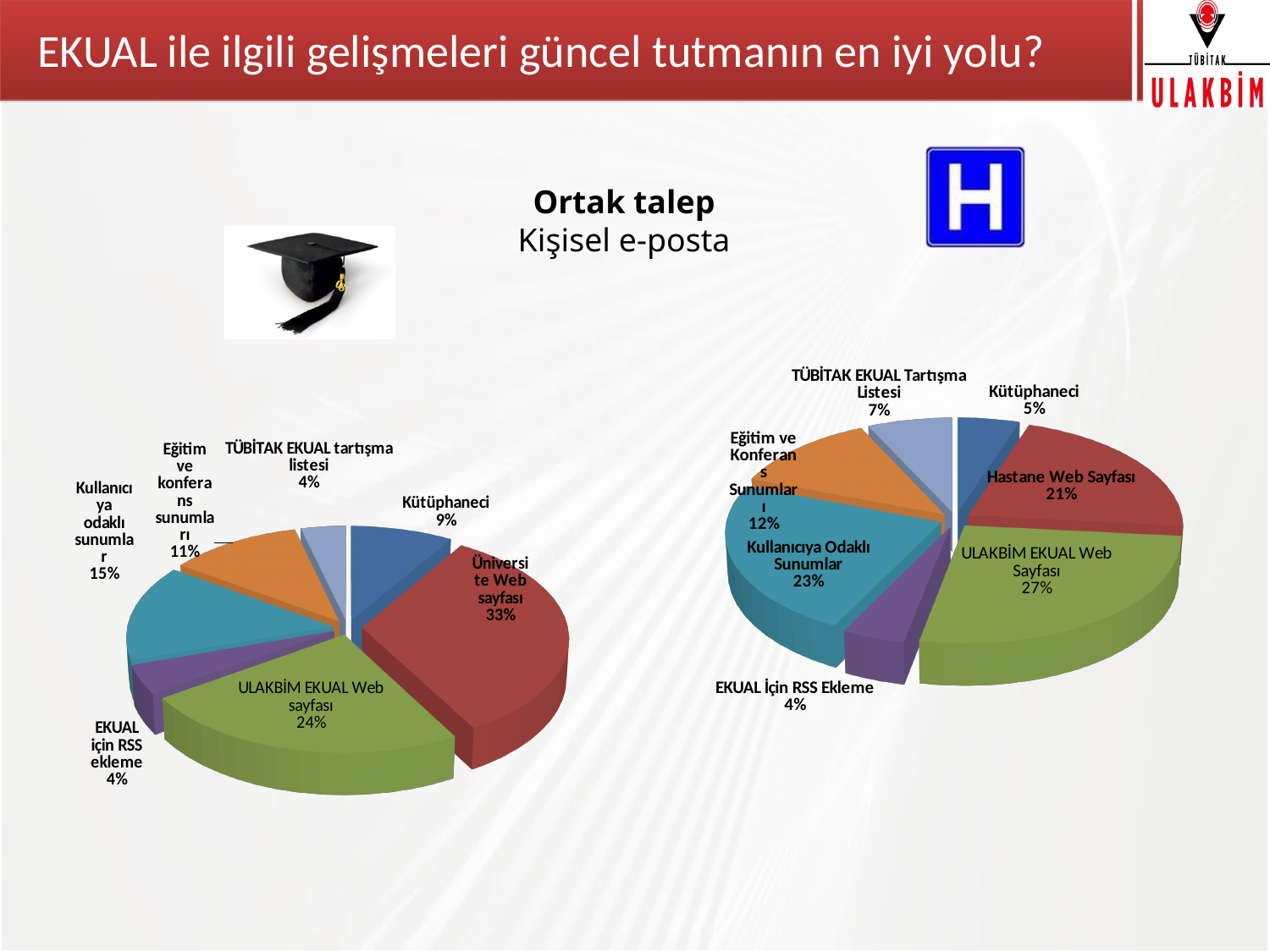
In the left pie chart, what is the difference between the shares of Üniversite Web sayfası and ULAKBİM EKUAL Web sayfası? 9 percentage points In the left pie chart, what share does Üniversite Web sayfası have? 33% In the right pie chart, which category has the largest share? ULAKBİM EKUAL Web Sayfası In the right pie chart, what share does Kütüphaneci have? 5% In the left pie chart, which category has the largest share? Üniversite Web sayfası In the right pie chart, which category has the smallest share? EKUAL İçin RSS Ekleme How many slices does the right pie chart have? 7 In the left pie chart, which is larger: Kullanıcıya odaklı sunumlar or Eğitim ve konferans sunumları? Kullanıcıya odaklı sunumlar In the right pie chart, which is larger: Kullanıcıya Odaklı Sunumlar or Hastane Web Sayfası? Kullanıcıya Odaklı Sunumlar In the right pie chart, what share does ULAKBİM EKUAL Web Sayfası have? 27% How many slices does the left pie chart have? 7 What type of chart is shown on the right side of the slide? Pie chart